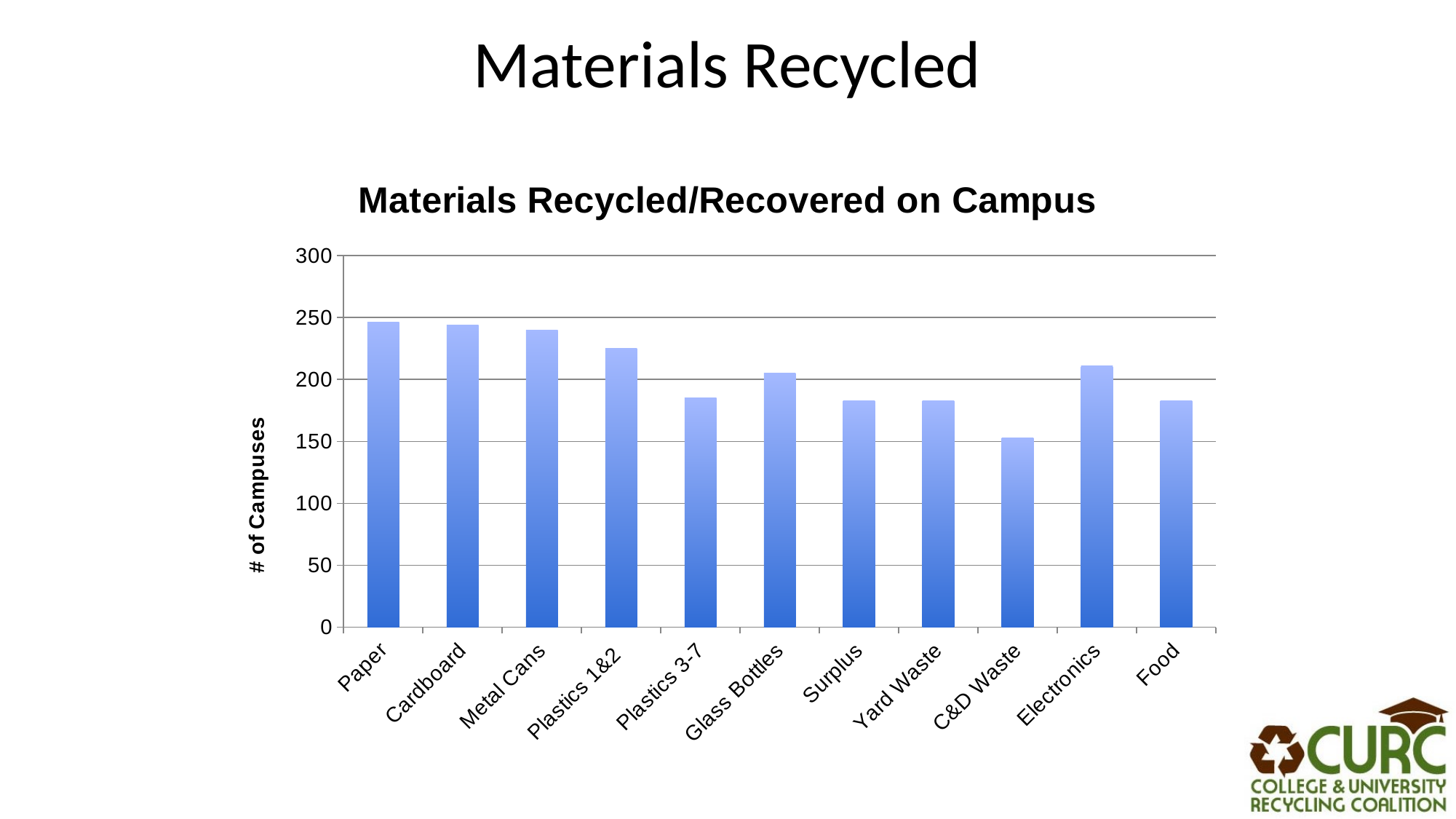
What kind of chart is shown on the slide? bar chart Which has more campuses, Plastics 1&2 or Glass Bottles? Plastics 1&2 Is the value for C&D Waste greater or less than 200? less Is the value for Food greater or less than 200? less Is the value for Metal Cans greater or less than 250? less Which has more campuses, Electronics or Plastics 3-7? Electronics What is the label on the y axis? # of Campuses How many material categories are shown on the x axis? 11 What is the title of the chart? Materials Recycled/Recovered on Campus Which material has the lowest number of campuses? C&D Waste